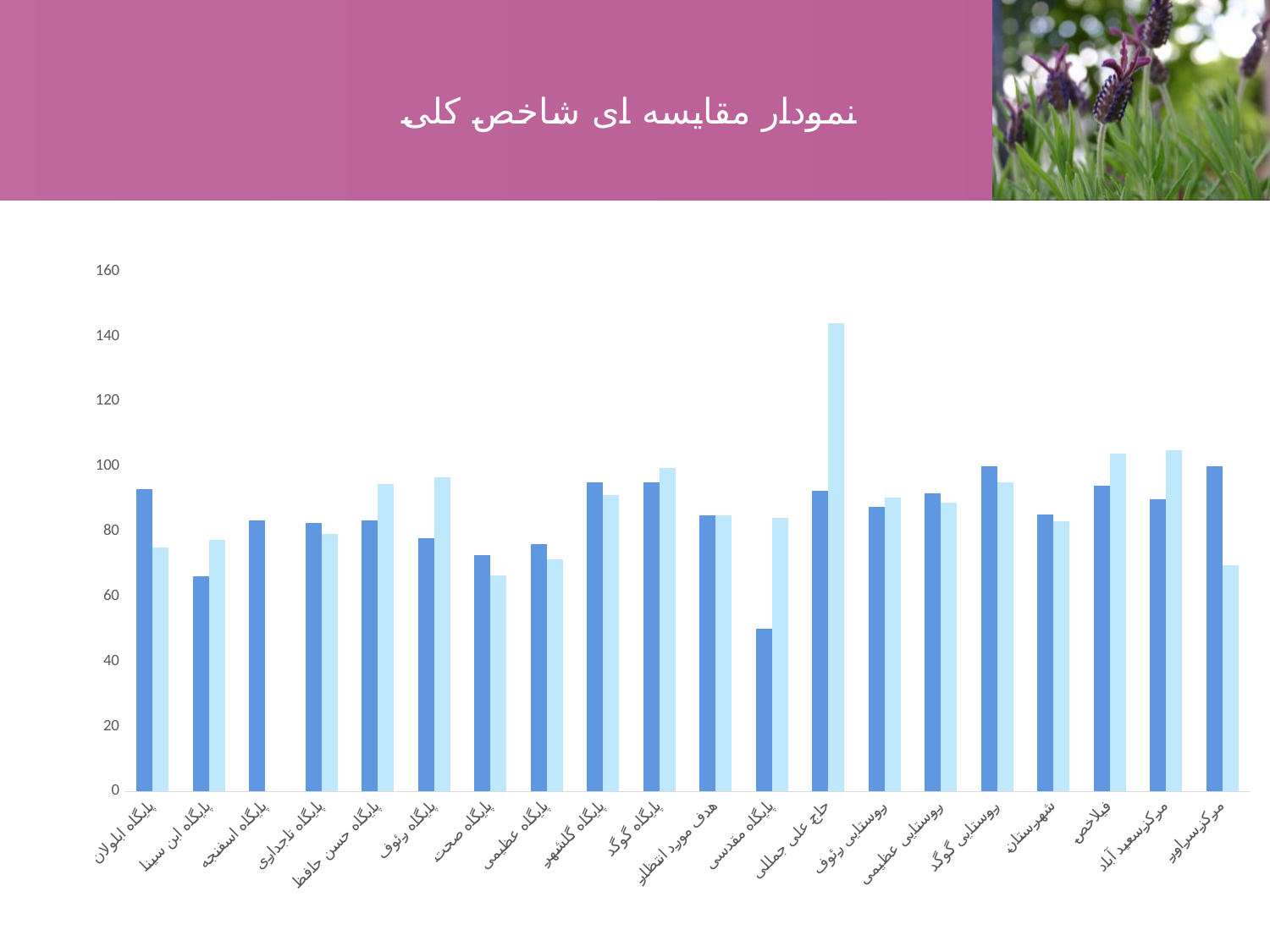
For پایگاه ایلولان, which bar is taller, the dark blue or the light blue? dark blue For پایگاه مقدسی, which bar is taller, the dark blue or the light blue? light blue Is the dark blue bar for پایگاه مقدسی greater or less than 60? less Is the dark blue bar for پایگاه ابن سینا greater or less than 80? less Which category has the lowest dark blue bar? پایگاه مقدسی How many categories are shown along the x axis of the chart? 20 Which category has the highest light blue bar? حاج علی جمالی What is the title of the chart? نمودار مقایسه ای شاخص کلی What kind of chart is shown on the slide? bar chart Is the light blue bar for حاج علی جملی greater or less than 120? greater